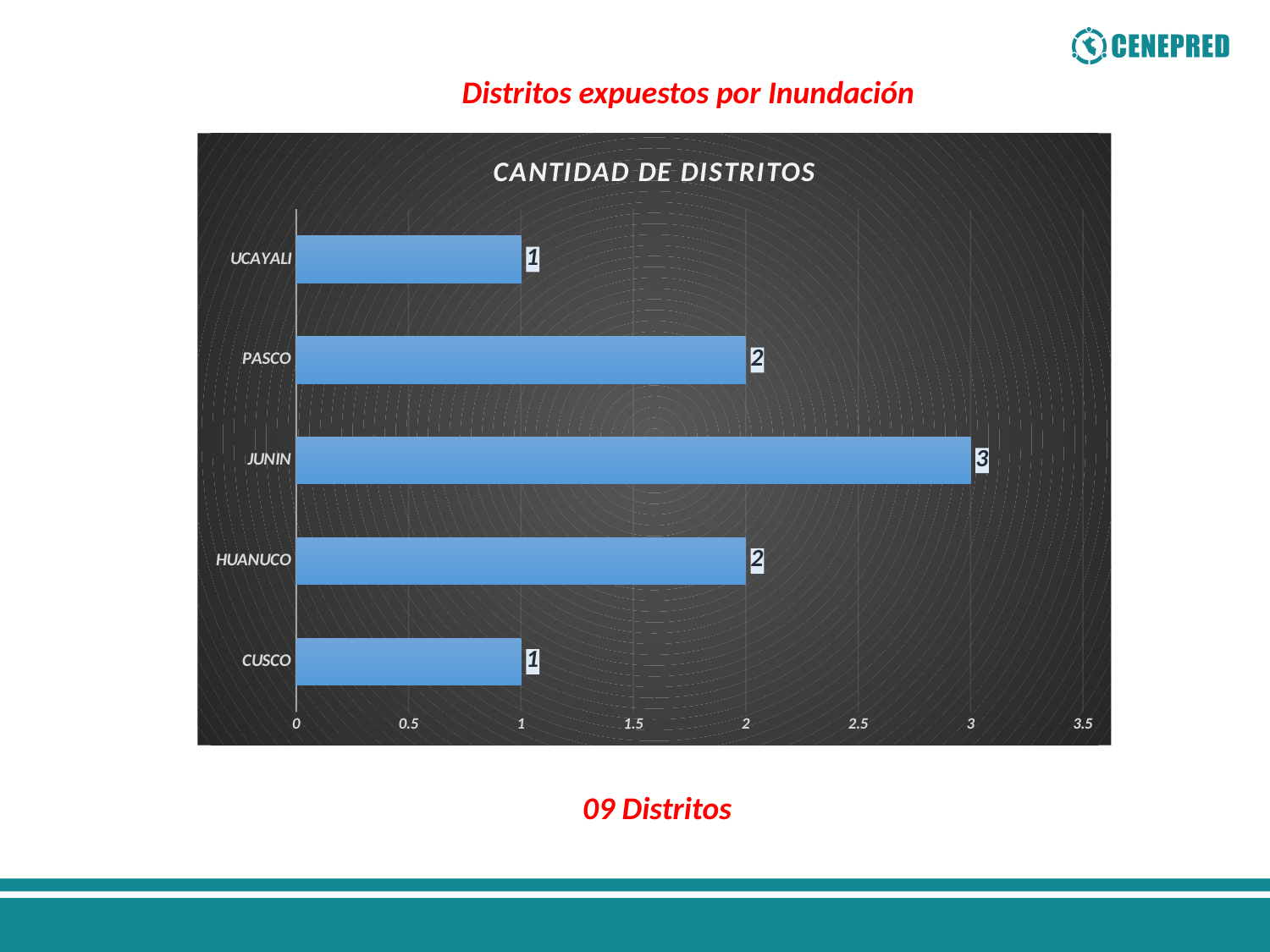
Which has a larger value, HUANUCO or CUSCO? HUANUCO What is the value for JUNIN in the chart? 3 What kind of chart is shown on the slide? bar chart Which category has the highest value in the chart? JUNIN What is the title of the chart? CANTIDAD DE DISTRITOS What is the highest value shown on the x axis of the chart? 3.5 How many categories are shown in the chart? 5 What is the sum of the values for HUANUCO and PASCO? 4 What is the difference between the values for JUNIN and UCAYALI? 2 Is the value for JUNIN greater or less than 2.5? greater What is the value for PASCO in the chart? 2 What is the value for CUSCO in the chart? 1